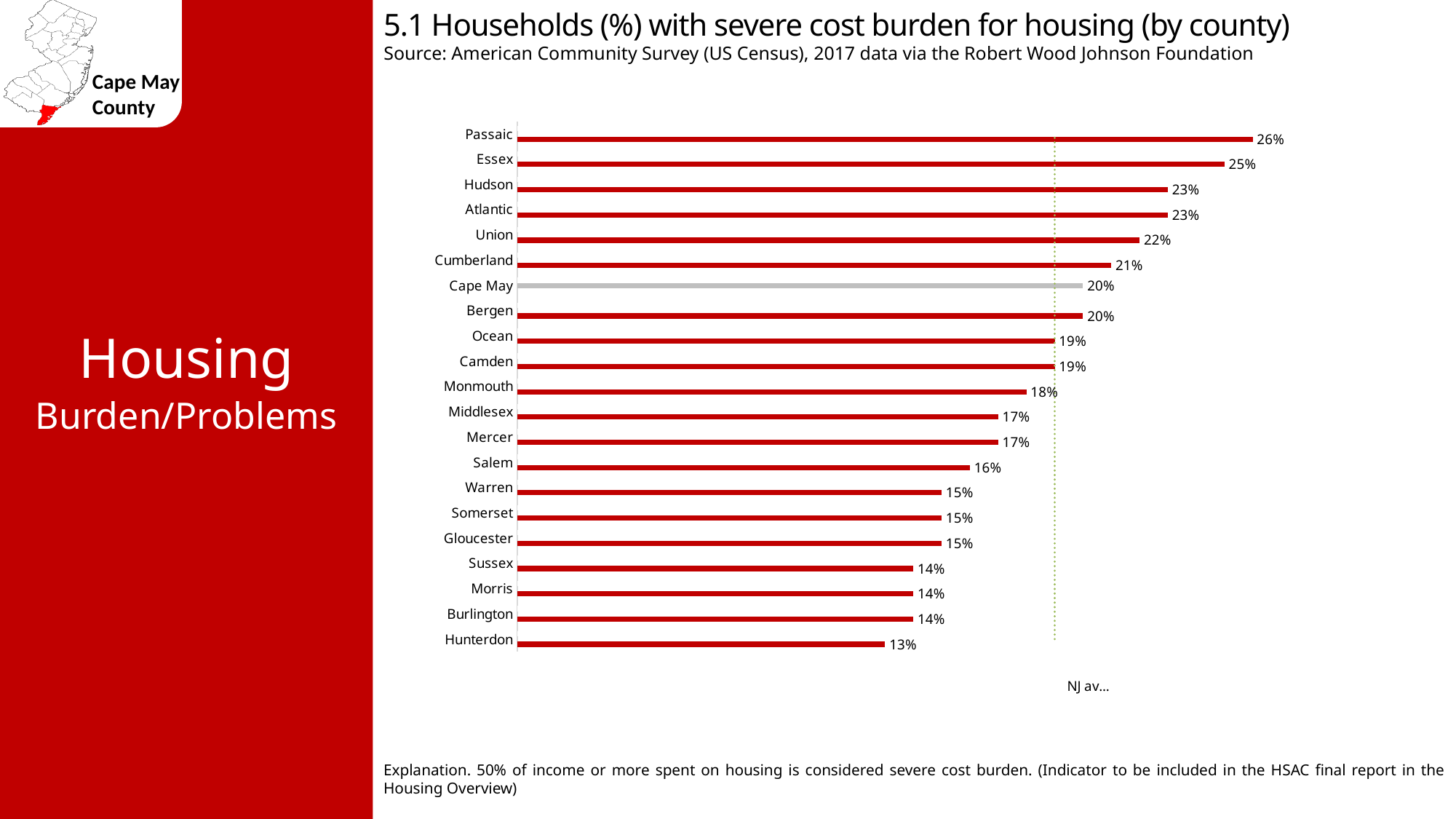
What is the difference between the values for Passaic and Hunterdon? 13% Which county has the highest value? Passaic Which is larger, the value for Union or the value for Salem? Union How many counties are shown in the chart? 21 What is the value for Hunterdon? 13% What is the value for Passaic? 26% What is the value for Cumberland? 21% Which county has the lowest value? Hunterdon What kind of chart is this? Bar chart Which county's bar is shown in a different colour (grey) from the others? Cape May What is the value for Cape May? 20% What is the difference between the values for Essex and Cape May? 5%